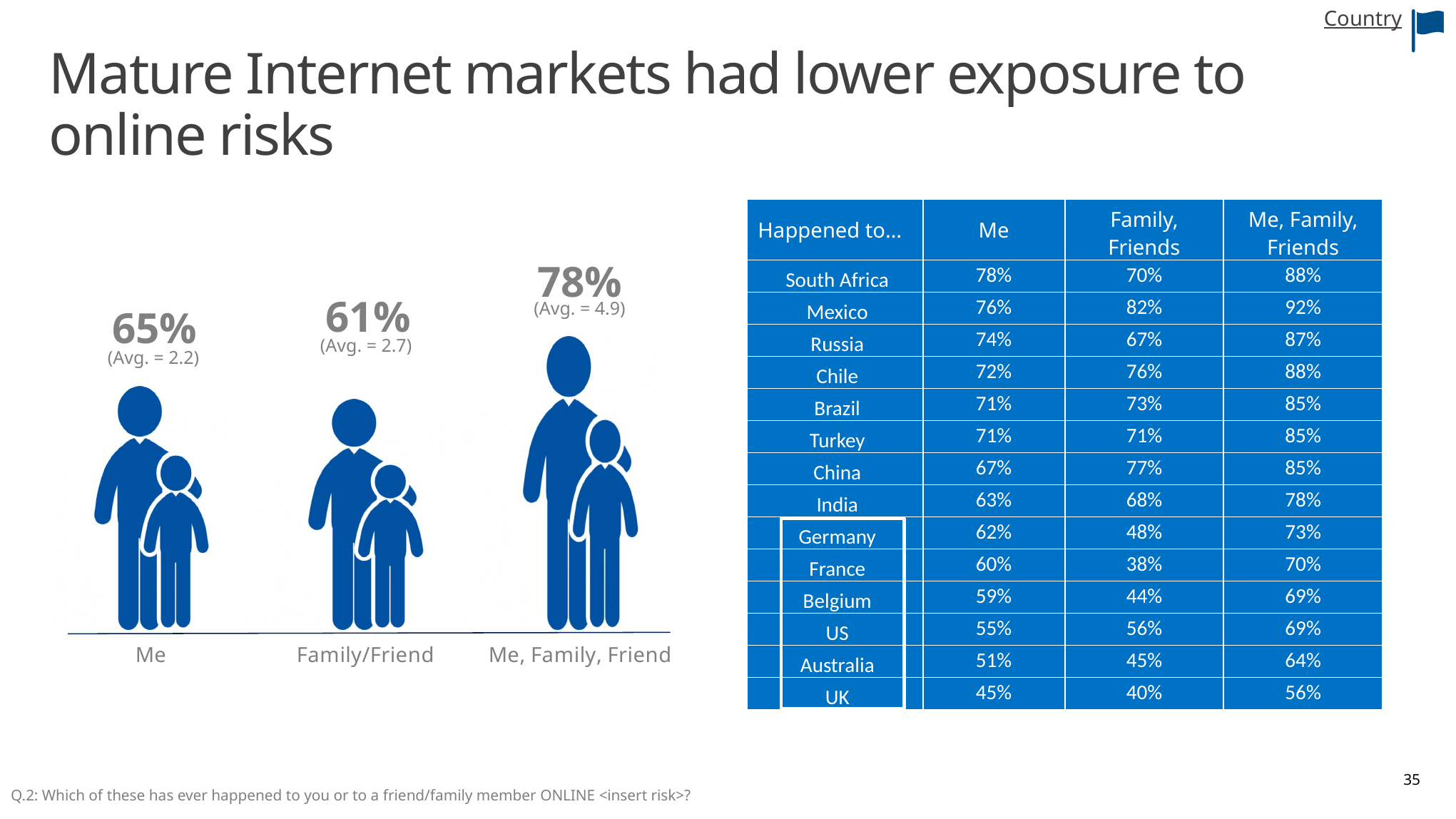
In the pictogram chart on the left, what percentage is shown for 'Me, Family, Friend'? 78% In the pictogram chart on the left, what average value is printed under the 'Me' percentage? Avg. = 2.2 In the pictogram chart on the left, which category has the highest percentage? Me, Family, Friend How many categories are shown in the pictogram chart on the left? 3 In the table on the right, what is the 'Me' value for Mexico? 76% In the pictogram chart on the left, what percentage is shown for 'Family/Friend'? 61% In the pictogram chart on the left, which category has the lowest percentage? Family/Friend In the pictogram chart on the left, which is larger: the percentage for 'Me' or for 'Family/Friend'? Me In the pictogram chart on the left, what is the difference between the 'Me, Family, Friend' percentage and the 'Me' percentage? 13% In the table on the right, which country has the lowest 'Me, Family, Friends' value? UK In the pictogram chart on the left, what average value is printed under the 'Me, Family, Friend' percentage? Avg. = 4.9 In the pictogram chart on the left, what percentage is shown for the 'Me' category? 65%